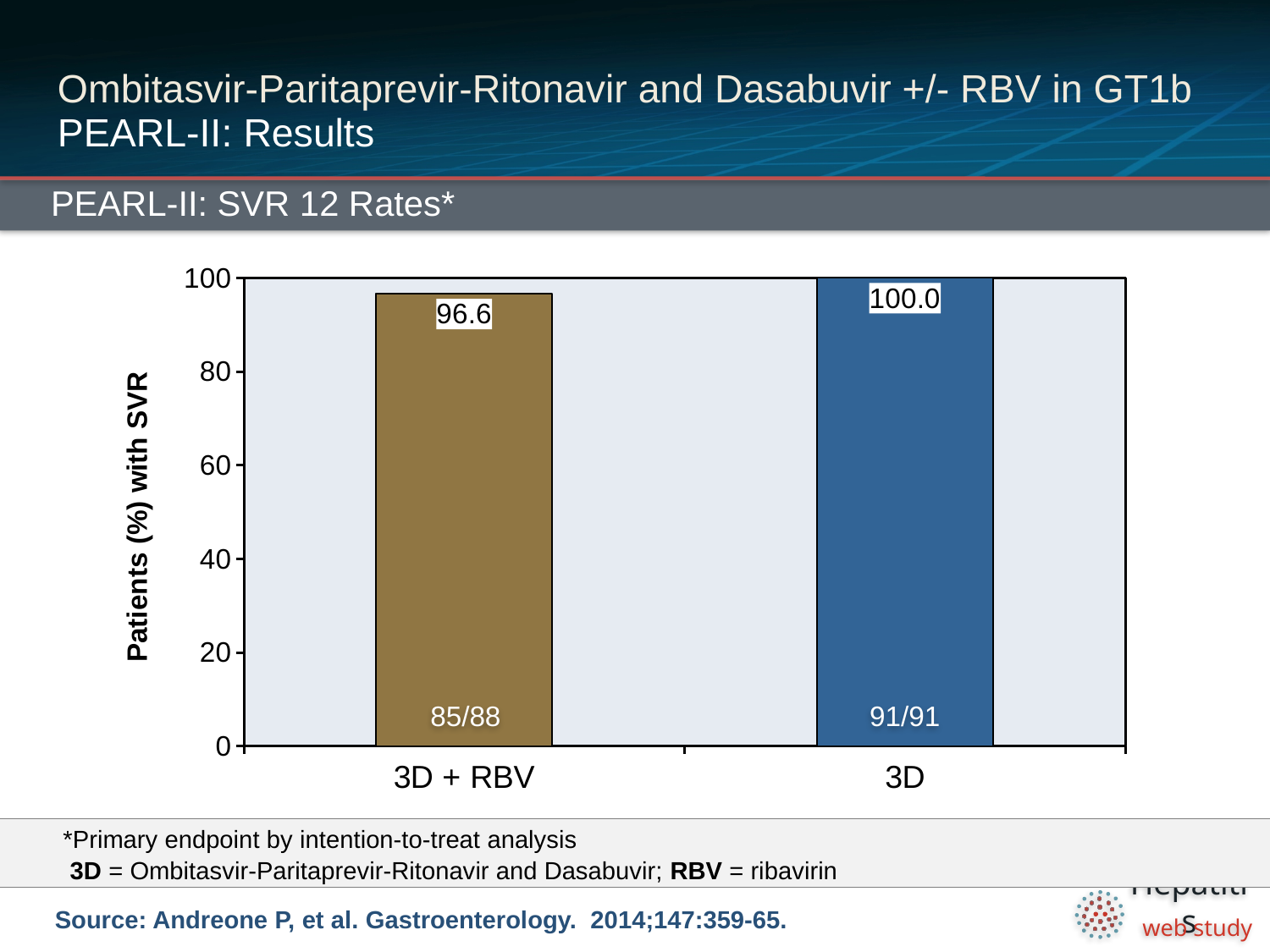
Which treatment group has the higher SVR 12 rate? 3D What is the SVR 12 rate for the 3D group? 100.0 Which treatment group has the lower SVR 12 rate? 3D + RBV What is the SVR 12 rate for the 3D + RBV group? 96.6 What is the difference in SVR 12 rate between the 3D group and the 3D + RBV group? 3.4 How many patients achieved SVR in the 3D + RBV group, as shown on the bar? 85/88 How many treatment groups are shown in the chart? 2 Is the SVR 12 rate for 3D + RBV greater or less than 80? greater What is the label of the y-axis? Patients (%) with SVR What type of chart is shown on the slide? Bar chart How many patients achieved SVR in the 3D group, as shown on the bar? 91/91 What is the title of the chart? PEARL-II: SVR 12 Rates*